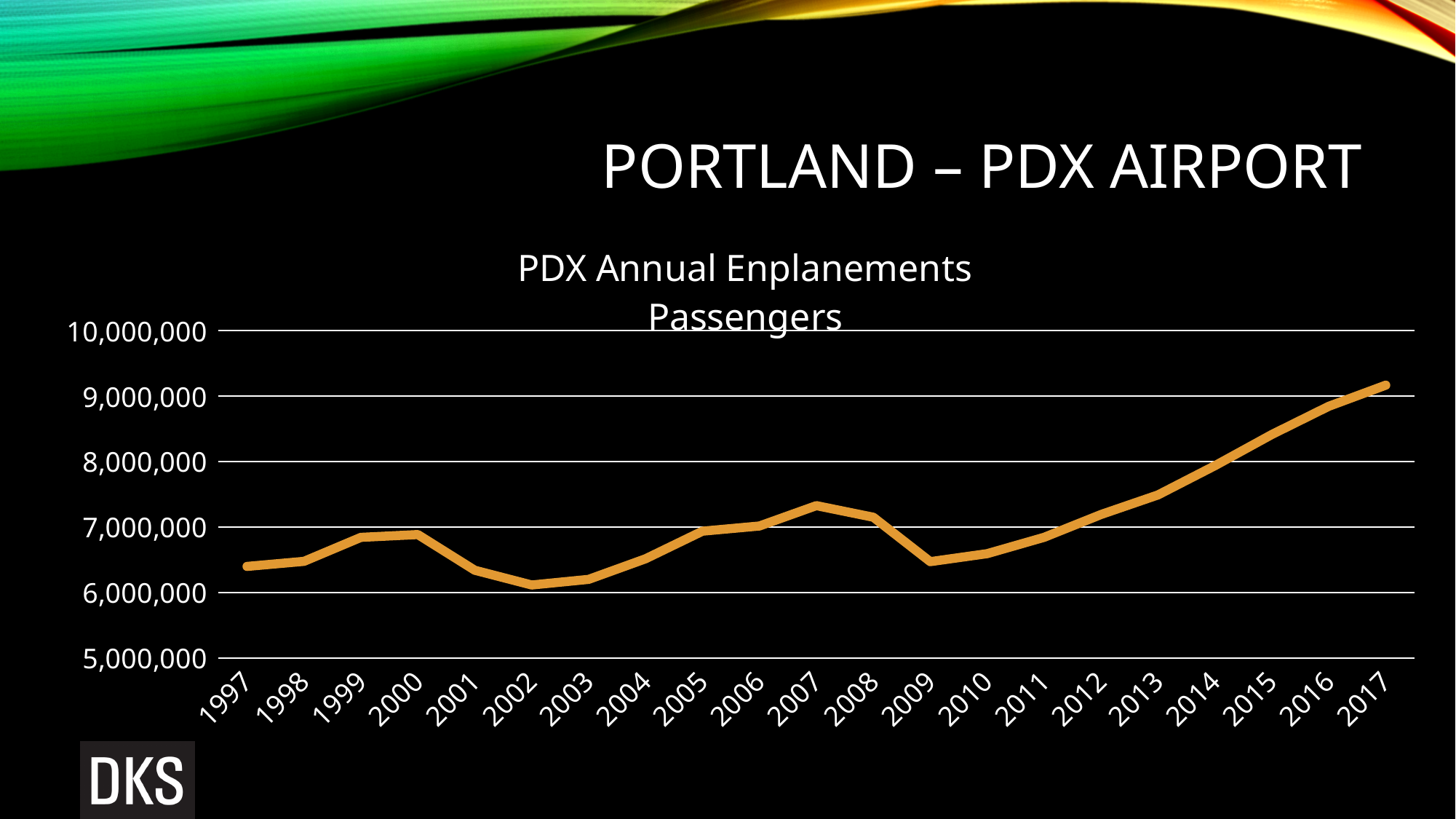
Overall, do enplanements rise or fall from 1997 to 2017? Rise Is the value for 2015 greater or less than 8,000,000? greater Which year has more enplanements, 2007 or 2009? 2007 What kind of chart is shown on the slide? Line chart How many years are plotted along the x axis of the chart? 21 Is the value for 2007 greater or less than 7,000,000? greater Is the value for 2009 greater or less than 7,000,000? less Which year has the highest number of enplanements? 2017 Which year has the lowest number of enplanements? 2002 What is the title of the chart? PDX Annual Enplanements Passengers